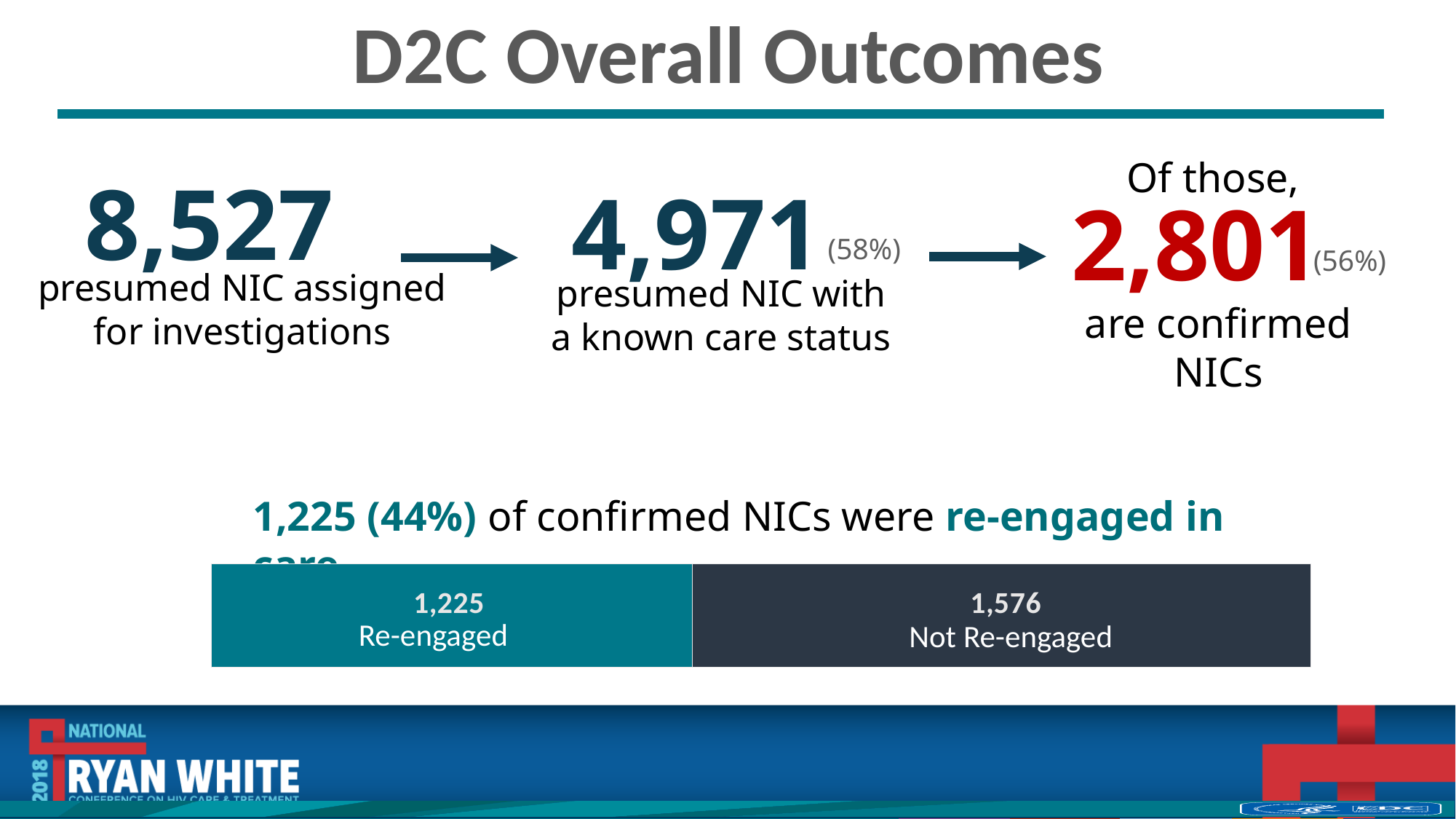
Which segment of the bar has the smallest value? Re-engaged What is the value for the Re-engaged segment of the bar? 1,225 What percentage of confirmed NICs were re-engaged in care, according to the slide? 44% Which segment of the bar is larger, Re-engaged or Not Re-engaged? Not Re-engaged What is the value for the Not Re-engaged segment of the bar? 1,576 What kind of chart is shown on the slide? bar chart What is the title of the slide containing the chart? D2C Overall Outcomes What is the total of the stacked bar (Re-engaged plus Not Re-engaged)? 2,801 How many segments does the stacked bar have? 2 What is the difference between the Not Re-engaged and Re-engaged values in the bar? 351 What colour is the Re-engaged segment of the bar? teal